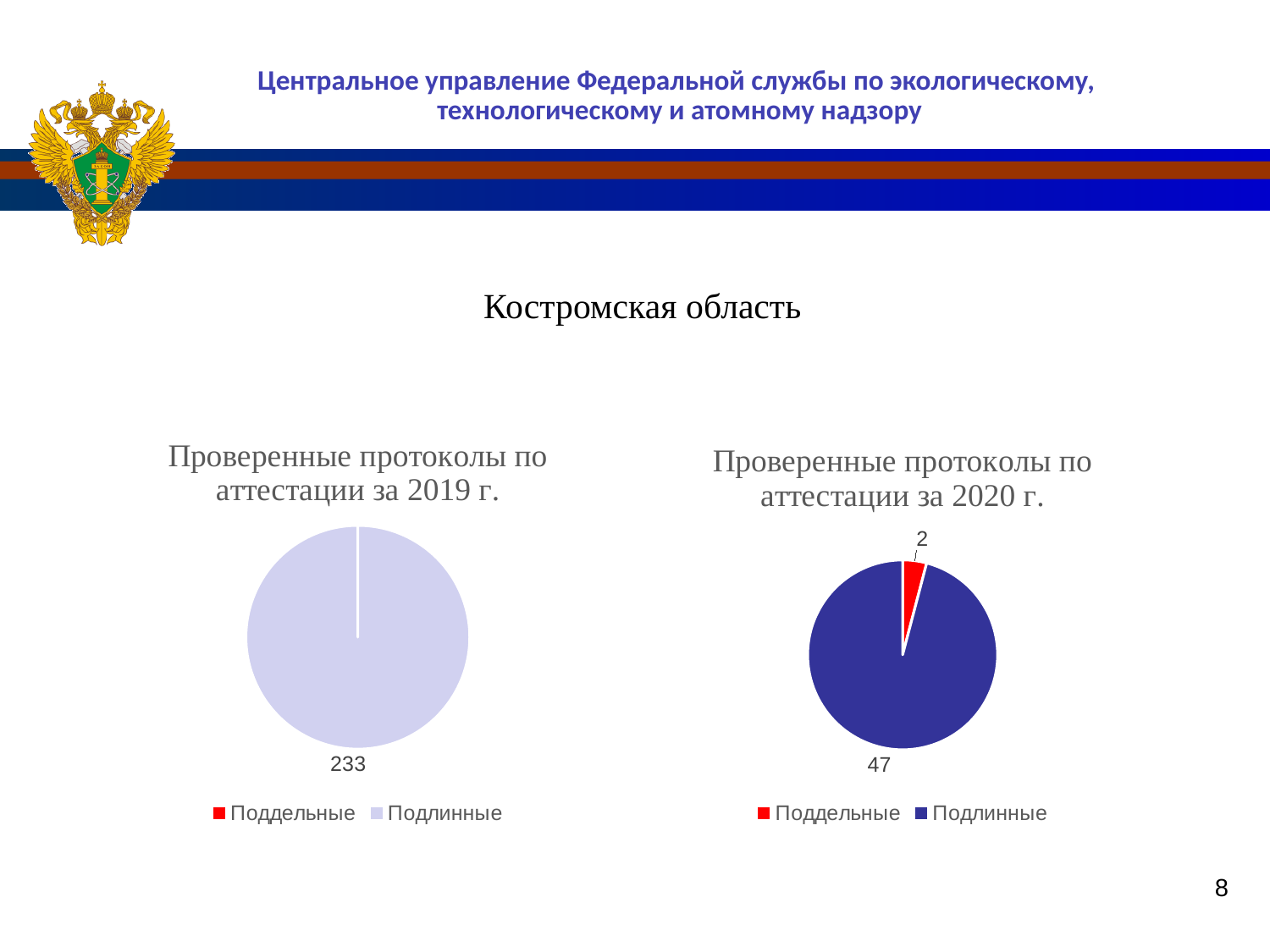
In the chart "Проверенные протоколы по аттестации за 2020 г.", what is the total of Поддельные and Подлинные? 49 In the chart "Проверенные протоколы по аттестации за 2020 г.", which category has the largest slice? Подлинные In the chart "Проверенные протоколы по аттестации за 2020 г.", what is the value for Подлинные? 47 How many pie charts are shown on the slide? 2 In the chart "Проверенные протоколы по аттестации за 2020 г.", what is the difference between Подлинные and Поддельные? 45 In the chart "Проверенные протоколы по аттестации за 2020 г.", is Подлинные larger or smaller than Поддельные? larger In the chart "Проверенные протоколы по аттестации за 2020 г.", which category has the smallest slice? Поддельные What kind of chart is used for "Проверенные протоколы по аттестации за 2019 г."? pie chart In the chart "Проверенные протоколы по аттестации за 2020 г.", what is the value for Поддельные? 2 In the chart "Проверенные протоколы по аттестации за 2020 г.", what colour is the Поддельные slice? red In the chart "Проверенные протоколы по аттестации за 2019 г.", what is the value for Подлинные? 233 How many entries does the legend of the chart "Проверенные протоколы по аттестации за 2019 г." list? 2